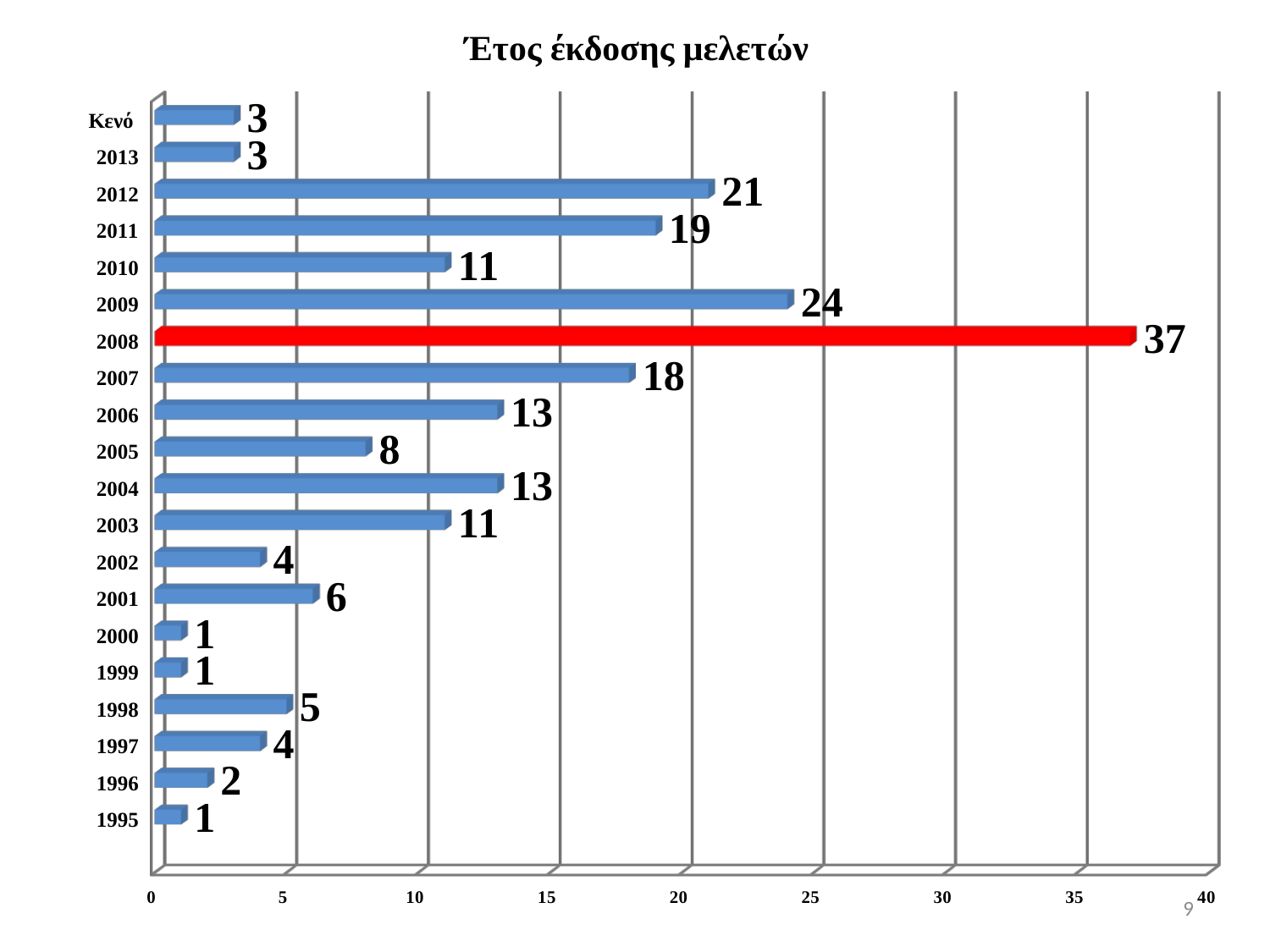
How many categories are shown on the chart? 20 Which bar is coloured red? 2008 What kind of chart is this? bar chart Which is larger, the value for 2011 or the value for 2007? 2011 What is the difference between the values for 2012 and 2013? 18 What is the title of the chart? Έτος έκδοσης μελετών Which category has the highest value? 2008 What is the value for 2008? 37 What is the value for Κενό? 3 Is the value for 2009 greater or less than 20? greater What is the difference between the values for 2009 and 2010? 13 What is the value for 2012? 21